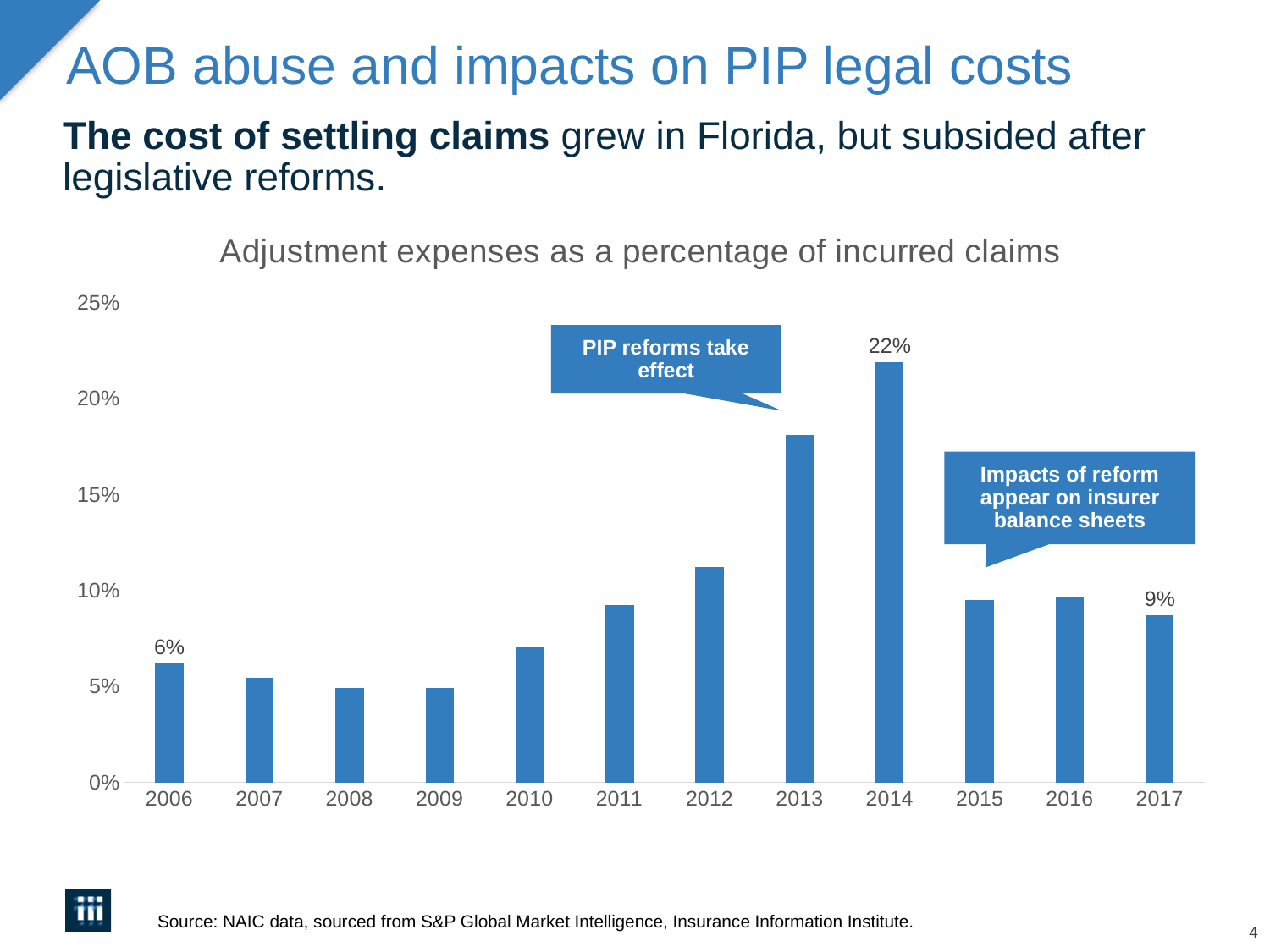
What is the chart's title? Adjustment expenses as a percentage of incurred claims What is the difference between the values for 2014 and 2006? 16 percentage points What is the value for 2017? 9% Is the value for 2013 greater or less than 15%? greater What type of chart is shown on the slide? Bar chart Which year has the highest value? 2014 How many years are shown on the x axis? 12 Which is larger, the value for 2013 or the value for 2012? 2013 What is the value for 2014? 22% What is the value for 2006? 6% Is the value for 2010 greater or less than 5%? greater Do the values rise or fall from 2014 to 2017? Fall